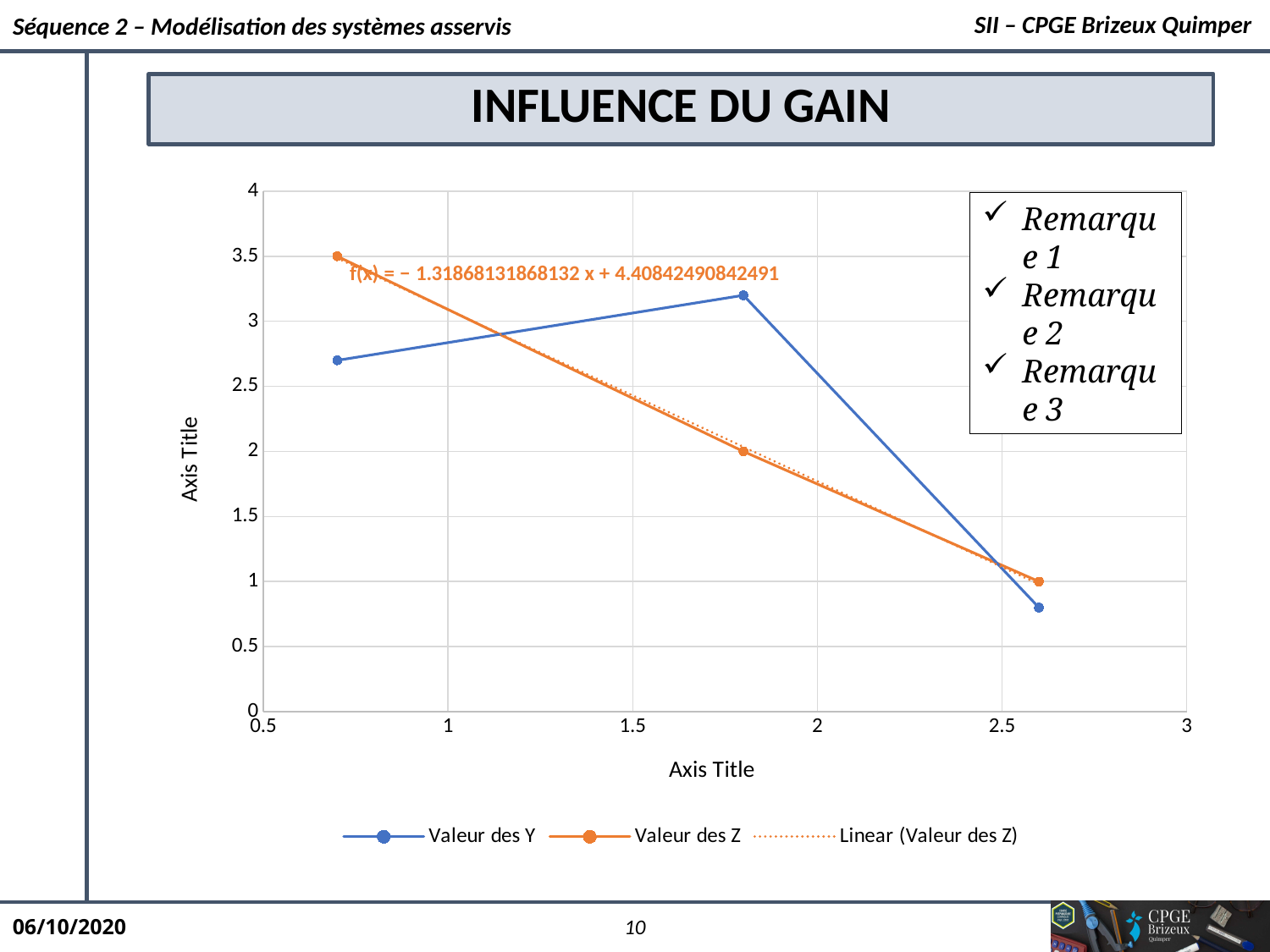
Is the value of Valeur des Y at its leftmost point greater or less than 2.5? greater What is the title of the chart's vertical axis? Axis Title How many data points does the Valeur des Z series have? 3 What is the value of Valeur des Z at the middle data point? 2 Which data point of Valeur des Z has the lowest value? the rightmost point (1) Is the value of Valeur des Y at its rightmost point greater or less than 1? less What kind of chart is shown on the slide? line chart How many entries does the chart legend list? 3 What is the value of Valeur des Z at the last (rightmost) data point? 1 At the middle data point, which series has the larger value, Valeur des Y or Valeur des Z? Valeur des Y Do the values of Valeur des Z rise or fall as x increases? fall What is the value of Valeur des Z at the first (leftmost) data point? 3.5